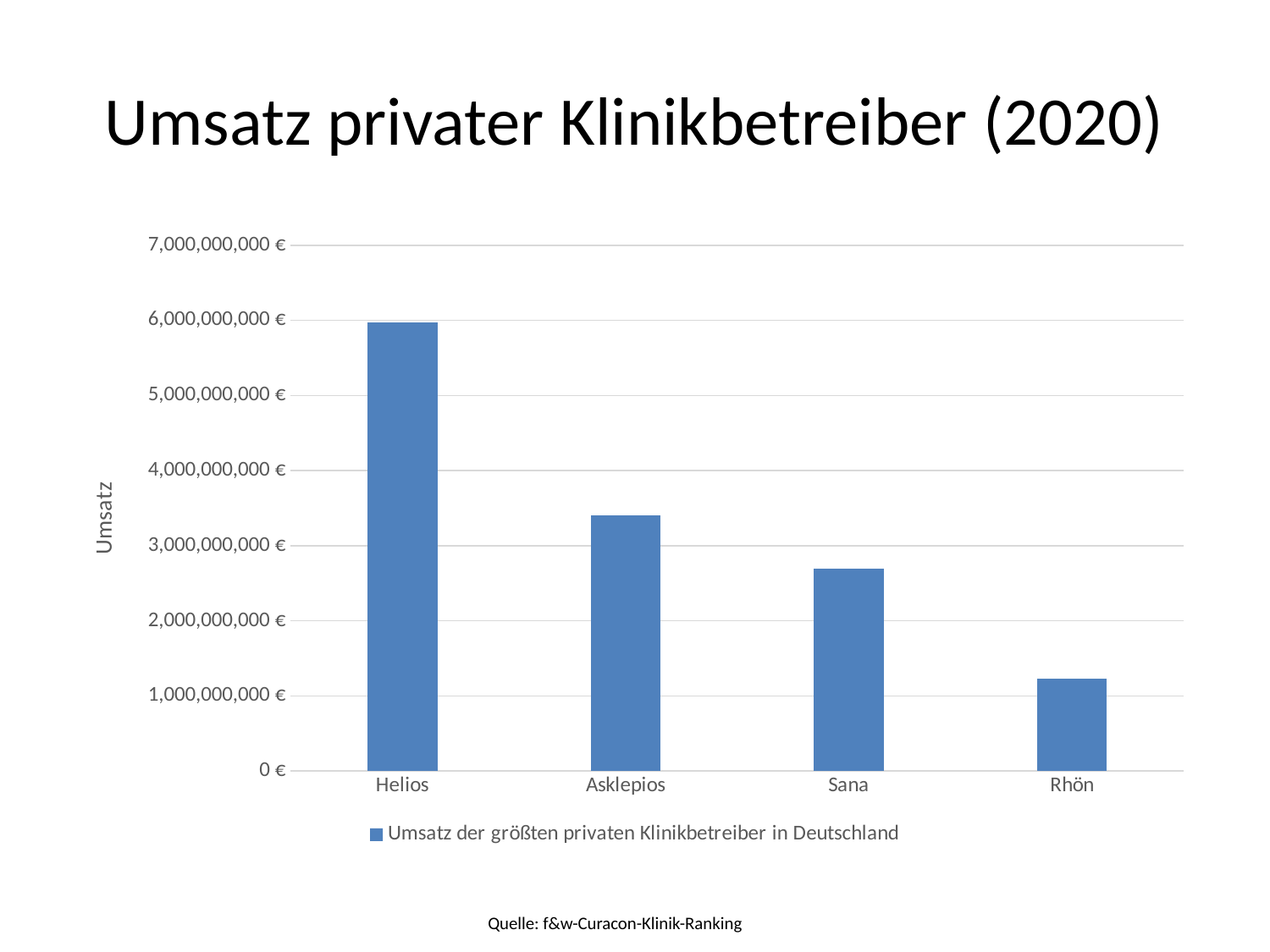
Is the value for Asklepios greater or less than 4,000,000,000 €? less What is the title of the chart on the slide? Umsatz privater Klinikbetreiber (2020) Is the value for Sana greater or less than 2,000,000,000 €? greater Is the value for Helios greater or less than 5,000,000,000 €? greater How many clinic operators are shown on the x axis? 4 What type of chart is shown on the slide? bar chart Which clinic operator has the lowest Umsatz? Rhön Do the values rise or fall from Helios to Rhön along the x axis? fall Which clinic operator has the highest Umsatz? Helios How many series does the legend list? 1 Which has the larger Umsatz, Asklepios or Sana? Asklepios